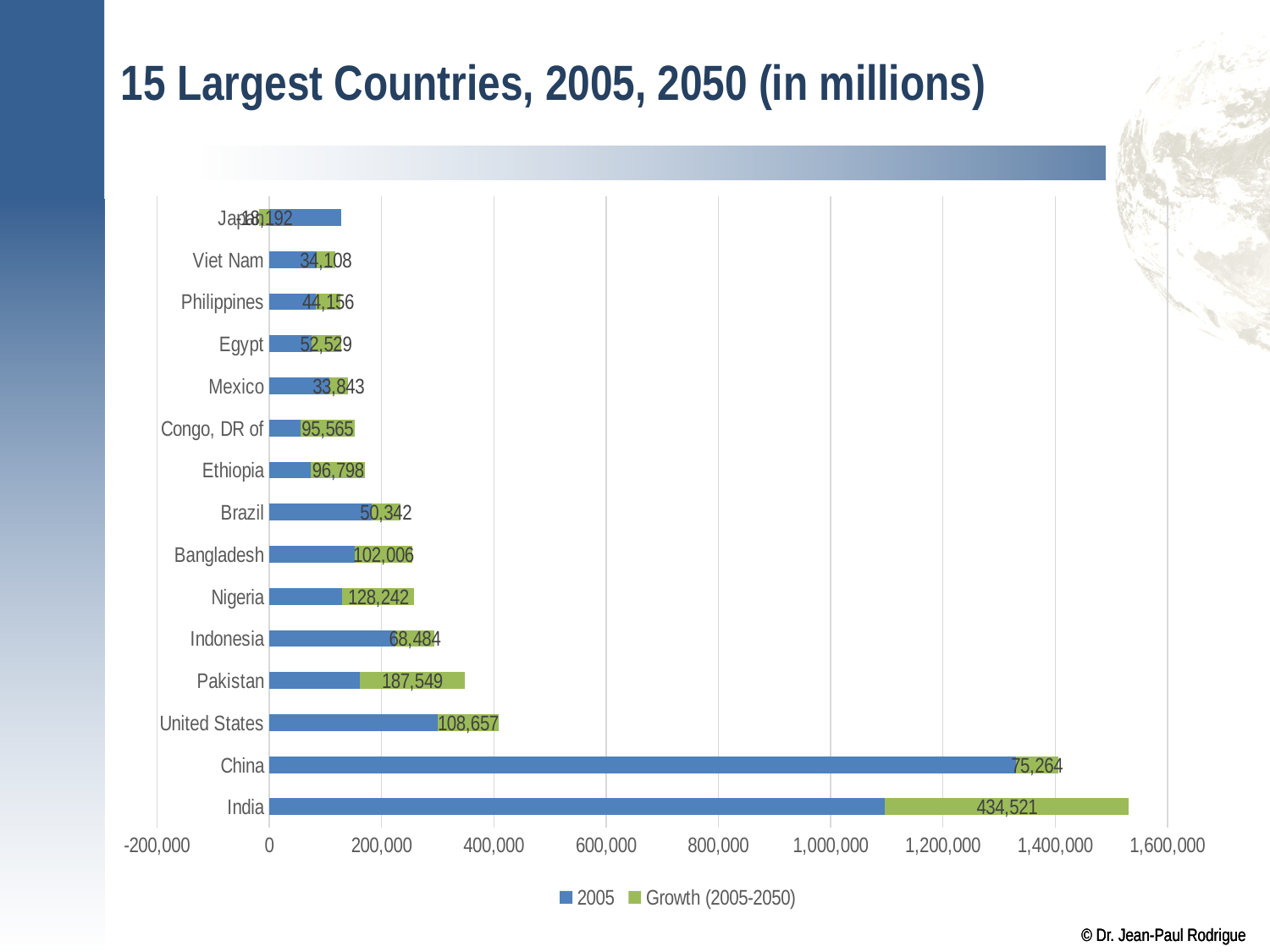
How many series does the legend list? 2 What is the Growth (2005-2050) value for China? 75,264 What is the Growth (2005-2050) value for Pakistan? 187,549 Which country has the smallest Growth (2005-2050) value? Japan What kind of chart is shown on the slide? Bar chart What is the Growth (2005-2050) value for India? 434,521 How many countries are shown in the chart? 15 What is the difference between the Growth (2005-2050) values for India and Pakistan? 246,972 Is the 2005 value for China greater or less than 1,200,000? greater What is the Growth (2005-2050) value for Nigeria? 128,242 Which country has the largest Growth (2005-2050) value? India Which has the larger Growth (2005-2050) value, Nigeria or Bangladesh? Nigeria